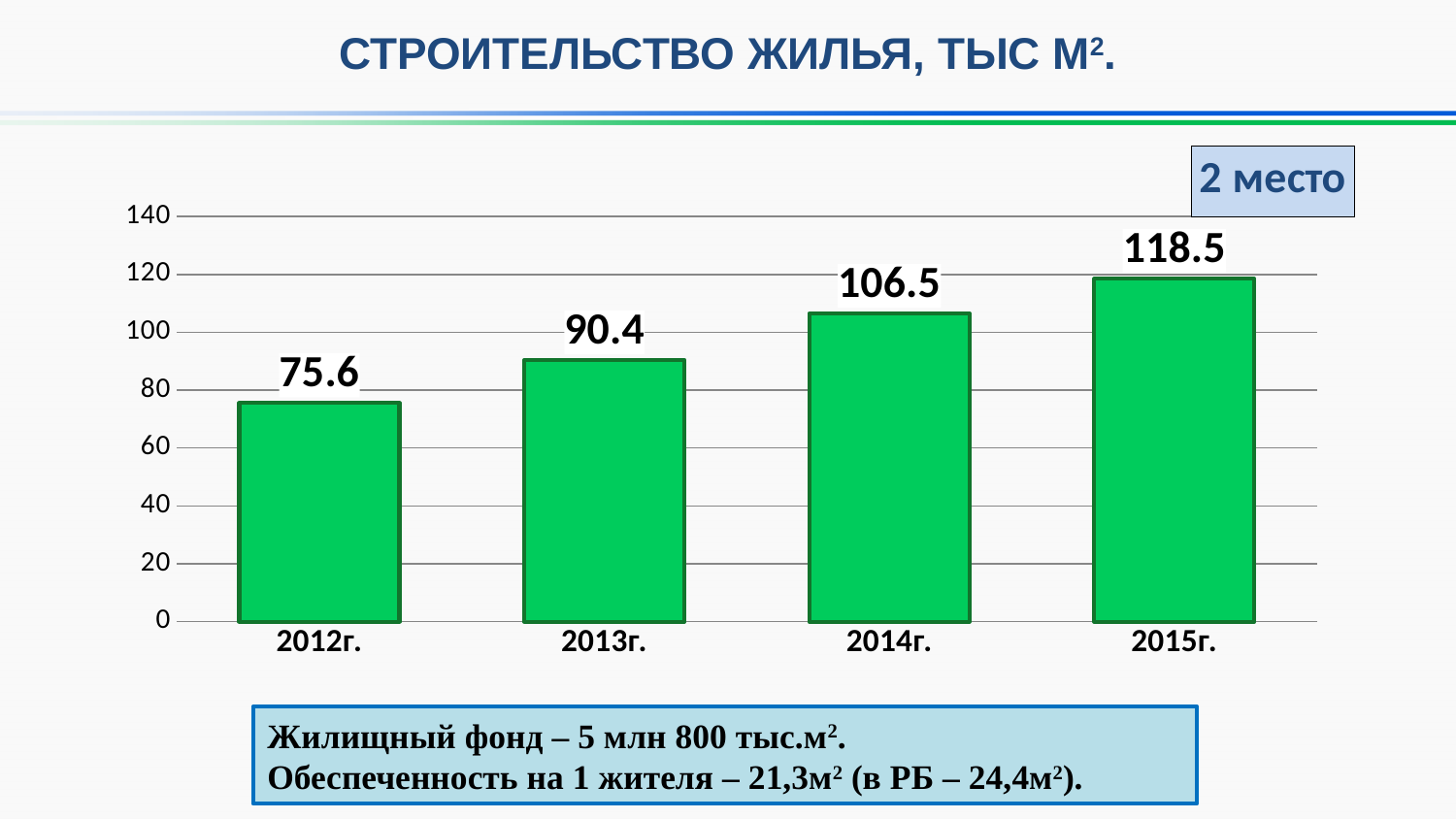
What is the difference between the values for 2015г. and 2012г.? 42.9 Which is larger, the value for 2013г. or the value for 2014г.? 2014г. Which year has the lowest value? 2012г. Is the value for 2013г. greater or less than 100? less What is the value for 2015г.? 118.5 What is the difference between the values for 2014г. and 2013г.? 16.1 How many years are shown on the chart? 4 Which year has the highest value? 2015г. What kind of chart is shown on the slide? bar chart What is the value for 2012г.? 75.6 What is the value for 2014г.? 106.5 Do the values rise or fall from 2012г. to 2015г.? rise